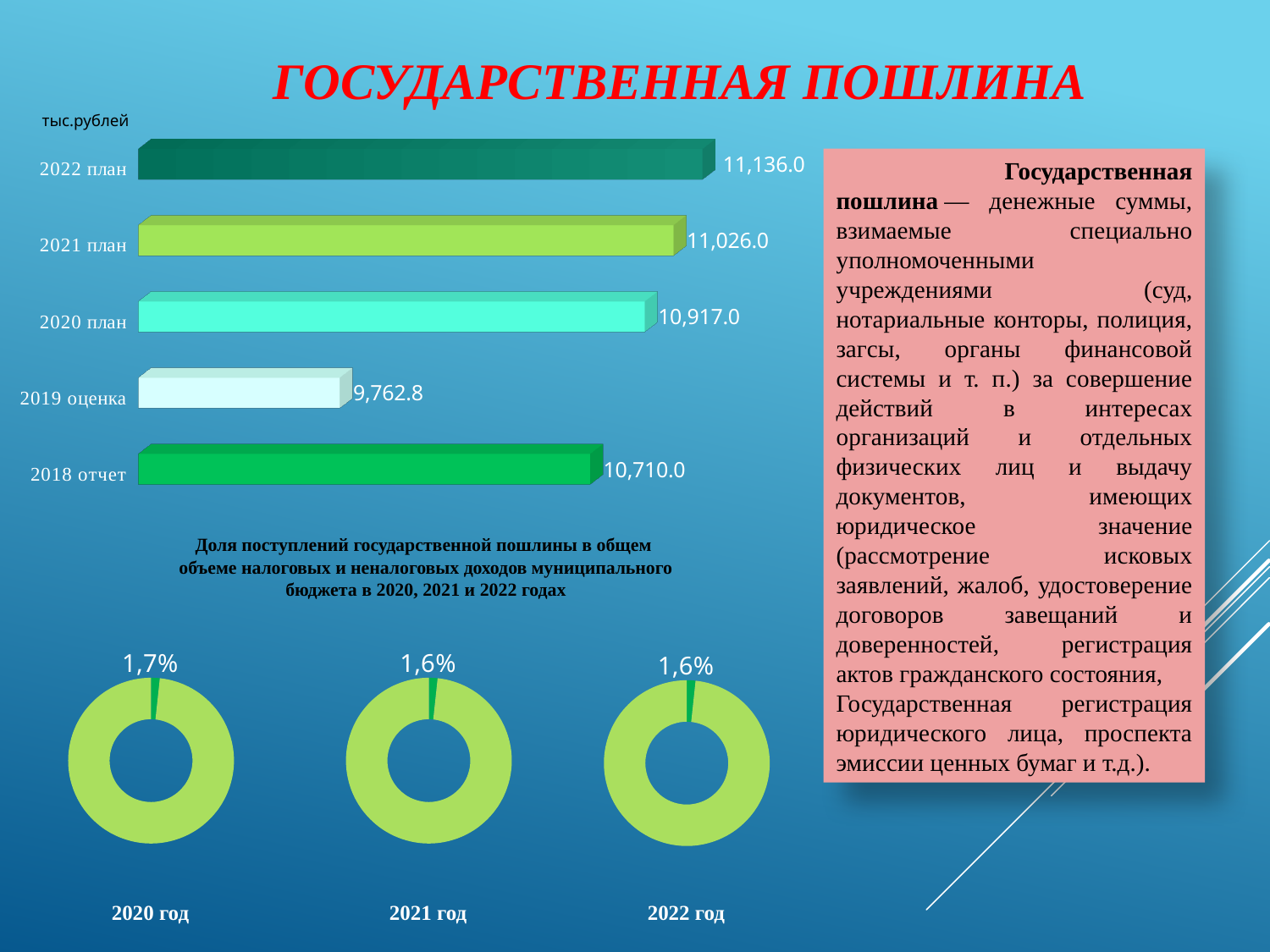
In the donut charts at the bottom of the slide, what share is shown for 2020 год? 1,7% How many categories are shown in the bar chart at the top of the slide? 5 In the bar chart at the top of the slide, which category has the highest value? 2022 план In the bar chart at the top of the slide, what is the difference between the values for 2020 план and 2019 оценка? 1,154.2 In the bar chart at the top of the slide, what is the value for 2018 отчет? 10,710.0 In the bar chart at the top of the slide, which is larger: the value for 2020 план or the value for 2018 отчет? 2020 план In the bar chart at the top of the slide, what is the difference between the values for 2022 план and 2021 план? 110.0 What kind of chart is shown at the top of the slide? Bar chart In the donut charts at the bottom of the slide, what share is shown for 2022 год? 1,6% In the bar chart at the top of the slide, which category has the lowest value? 2019 оценка In the bar chart at the top of the slide, what is the value for 2019 оценка? 9,762.8 In the bar chart at the top of the slide, what is the value for 2022 план? 11,136.0